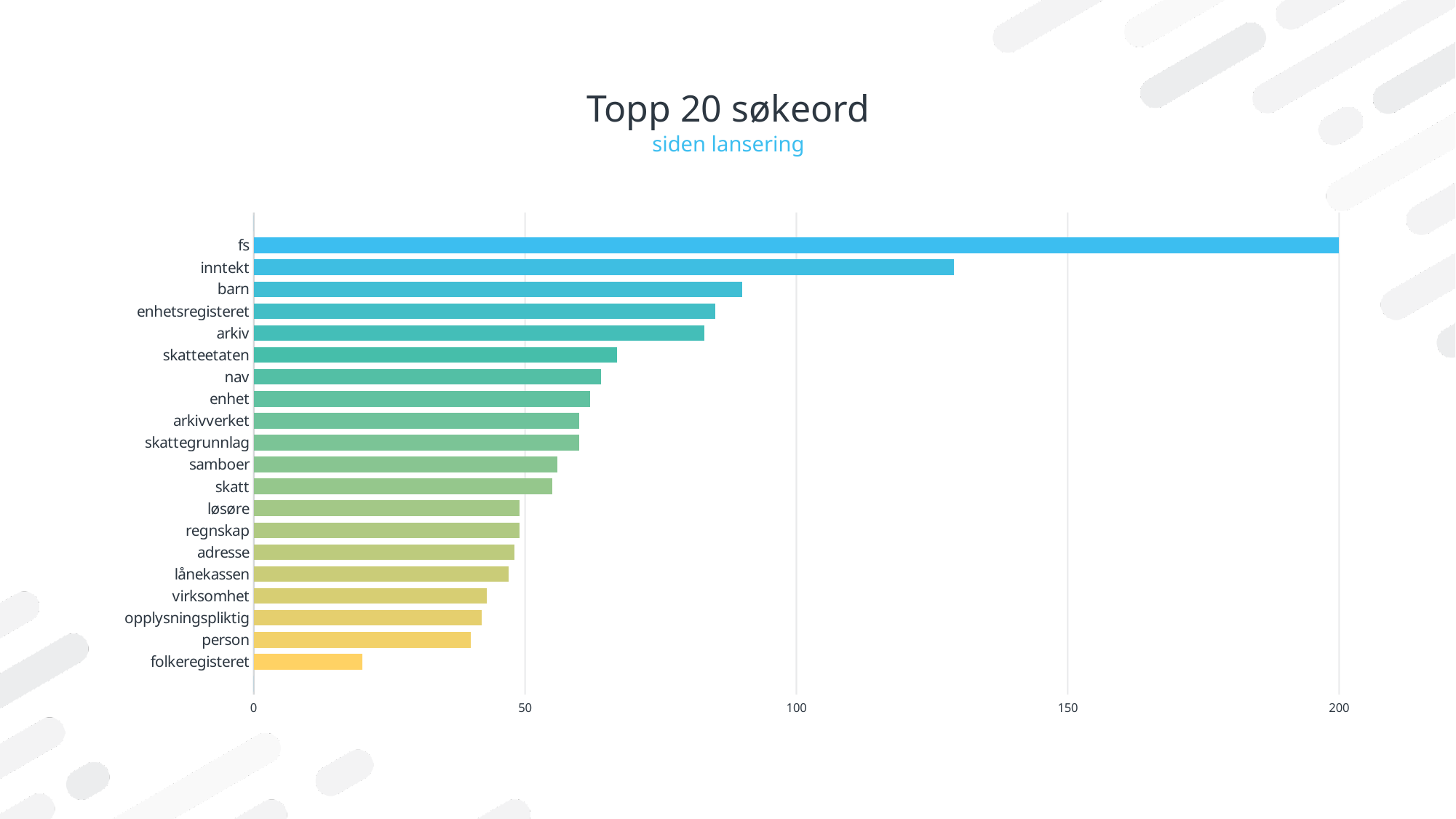
Which search term has the lowest value? folkeregisteret Is the value for inntekt greater or less than 100? greater Is the value for barn greater or less than 100? less What is the title of the chart? Topp 20 søkeord Which search term has the highest value? fs Is the value for skatteetaten greater or less than 50? greater Do the bar values increase or decrease going from the top of the chart to the bottom? decrease How many categories (search terms) are plotted in the chart? 20 What kind of chart is shown on the slide? bar chart Which has a larger value, inntekt or barn? inntekt